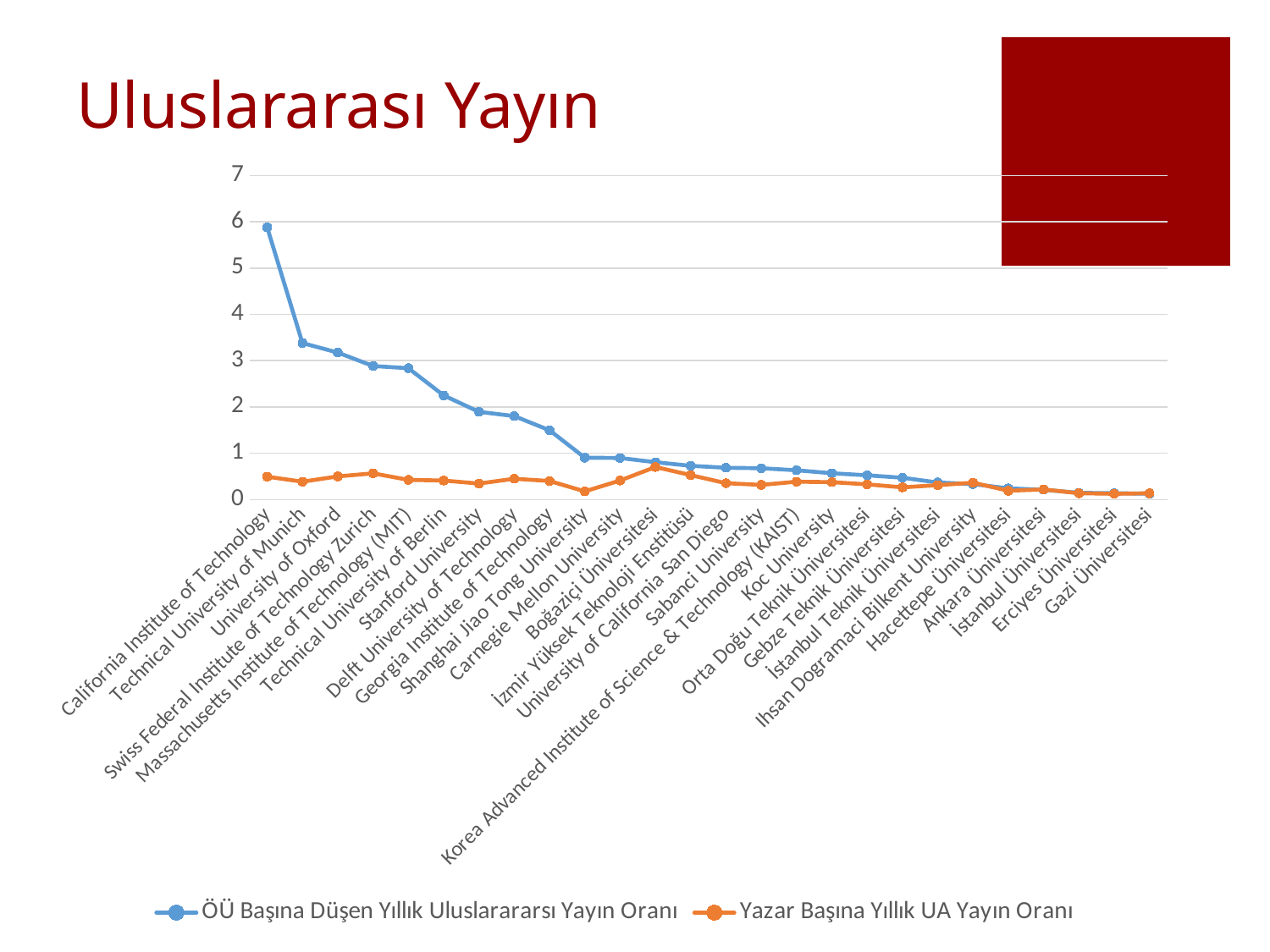
How many universities are plotted along the x axis? 26 What kind of chart is shown on the slide? line chart Does the ÖÜ Başına Düşen Yıllık Uluslararası Yayın Oranı series generally rise or fall from left to right along the x axis? fall Which university has the highest value for the ÖÜ Başına Düşen Yıllık Uluslararası Yayın Oranı series? California Institute of Technology Which has the larger ÖÜ Başına Düşen Yıllık Uluslararası Yayın Oranı value: California Institute of Technology or University of Oxford? California Institute of Technology Which is larger for California Institute of Technology: the ÖÜ Başına Düşen Yıllık Uluslararası Yayın Oranı value or the Yazar Başına Yıllık UA Yayın Oranı value? ÖÜ Başına Düşen Yıllık Uluslararası Yayın Oranı Is the Yazar Başına Yıllık UA Yayın Oranı value for California Institute of Technology greater or less than 1? less Is the ÖÜ Başına Düşen Yıllık Uluslararası Yayın Oranı value for Georgia Institute of Technology greater or less than 2? less Is the ÖÜ Başına Düşen Yıllık Uluslararası Yayın Oranı value for California Institute of Technology greater or less than 5? greater How many series does the legend list? 2 What is the title of the slide containing the chart? Uluslararası Yayın